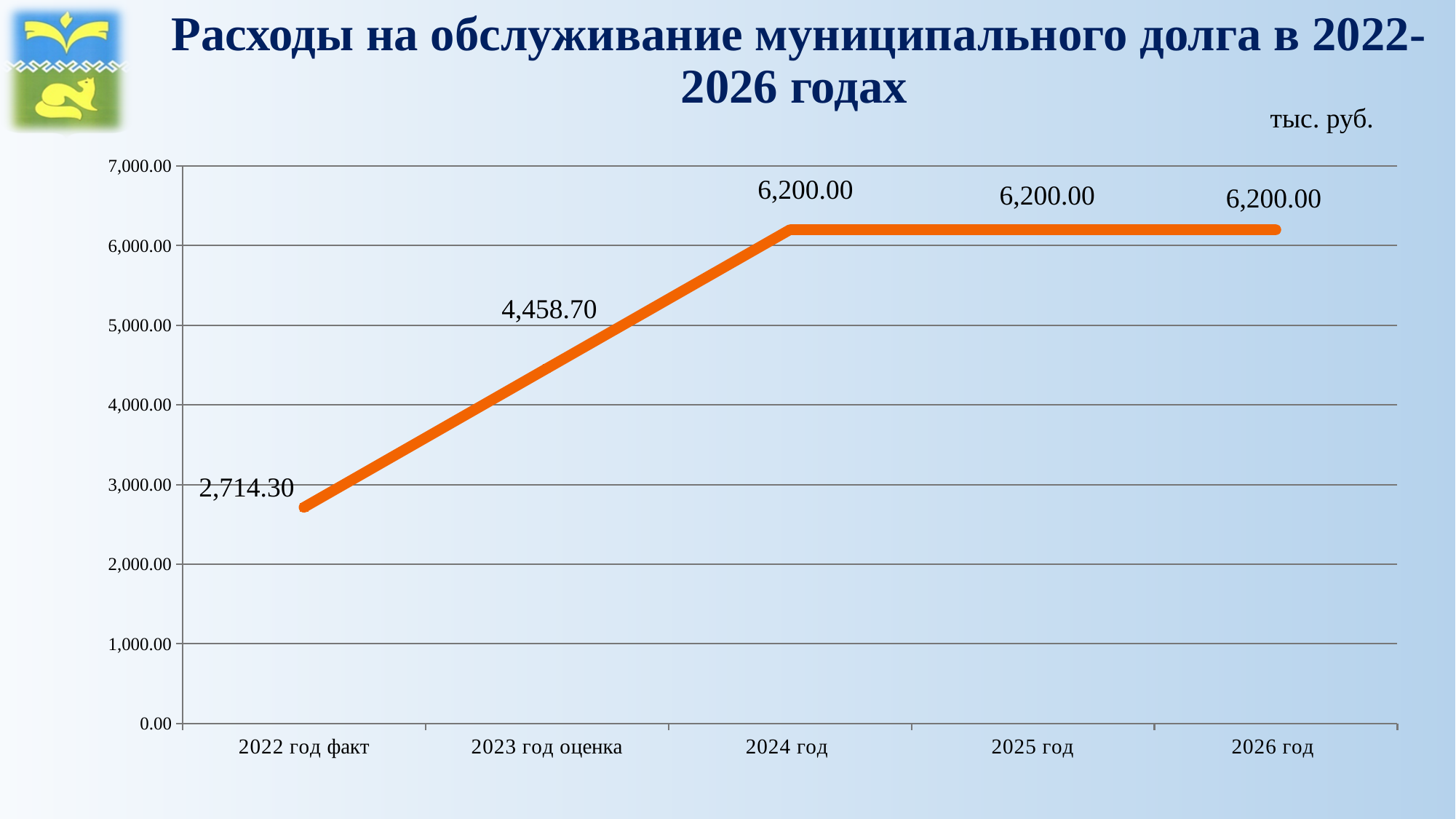
What is the value for 2026 год? 6,200.00 What is the value for 2023 год оценка? 4,458.70 Which is larger, the value for 2023 год оценка or the value for 2022 год факт? 2023 год оценка Do the values rise or fall from 2022 год факт to 2024 год? rise What is the value for 2024 год? 6,200.00 How many categories are shown on the x axis? 5 What kind of chart is this? line chart What is the value for 2022 год факт? 2,714.30 What is the difference between the values for 2024 год and 2023 год оценка? 1,741.30 What is the difference between the values for 2023 год оценка and 2022 год факт? 1,744.40 Is the value for 2023 год оценка greater or less than 4,000.00? greater Which category has the lowest value? 2022 год факт